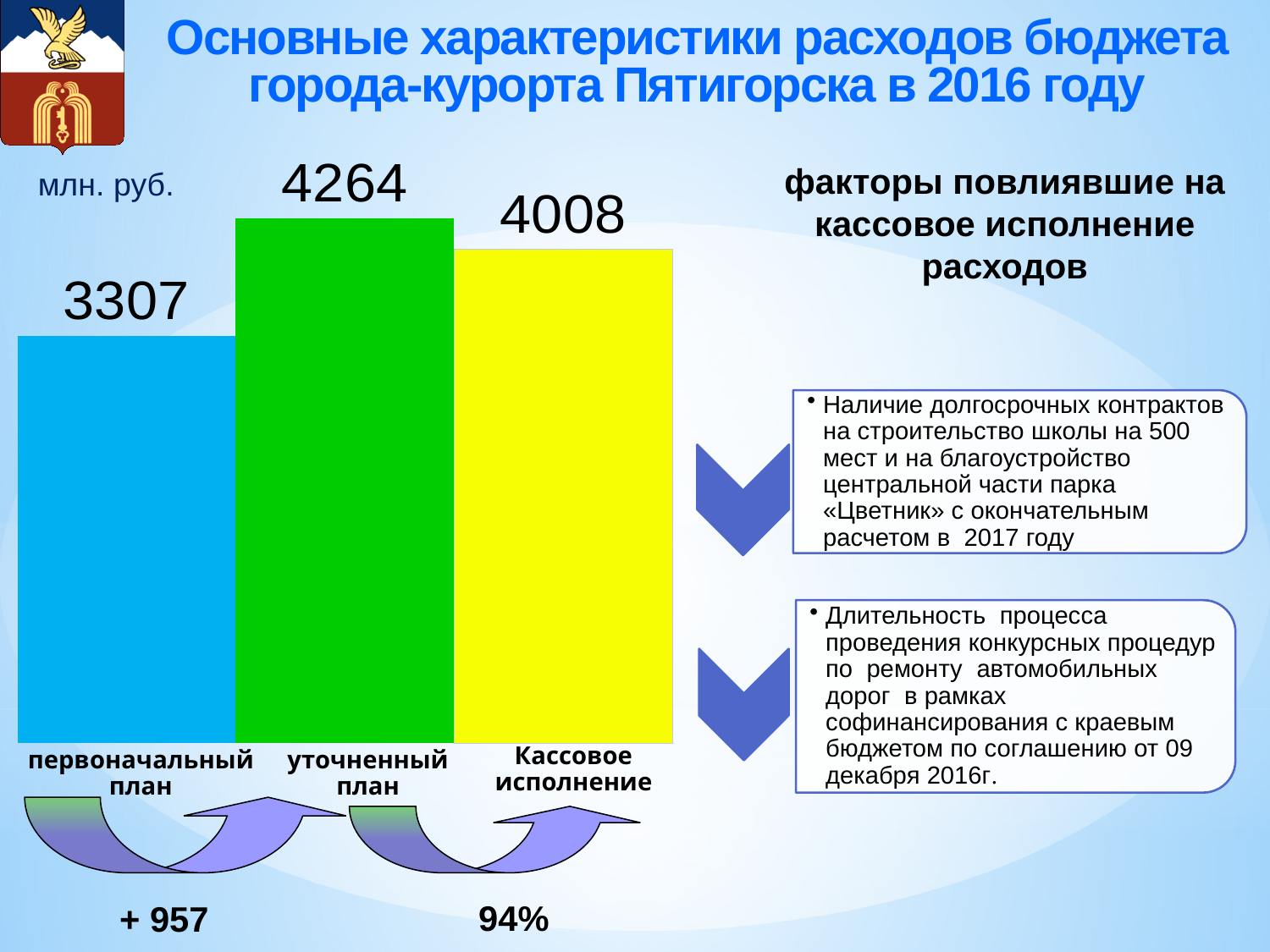
What is the value for Кассовое исполнение? 4008 How many categories are shown in the chart? 3 What colour is the bar for уточненный план? green What unit of measurement is indicated for the chart values? млн. руб. Which category has the lowest value? первоначальный план What is the value for первоначальный план? 3307 Which category has the highest value? уточненный план What is the difference between уточненный план and первоначальный план? 957 What is the value for уточненный план? 4264 Which is larger, Кассовое исполнение or первоначальный план? Кассовое исполнение What kind of chart is shown on the slide? bar chart What is the difference between уточненный план and Кассовое исполнение? 256